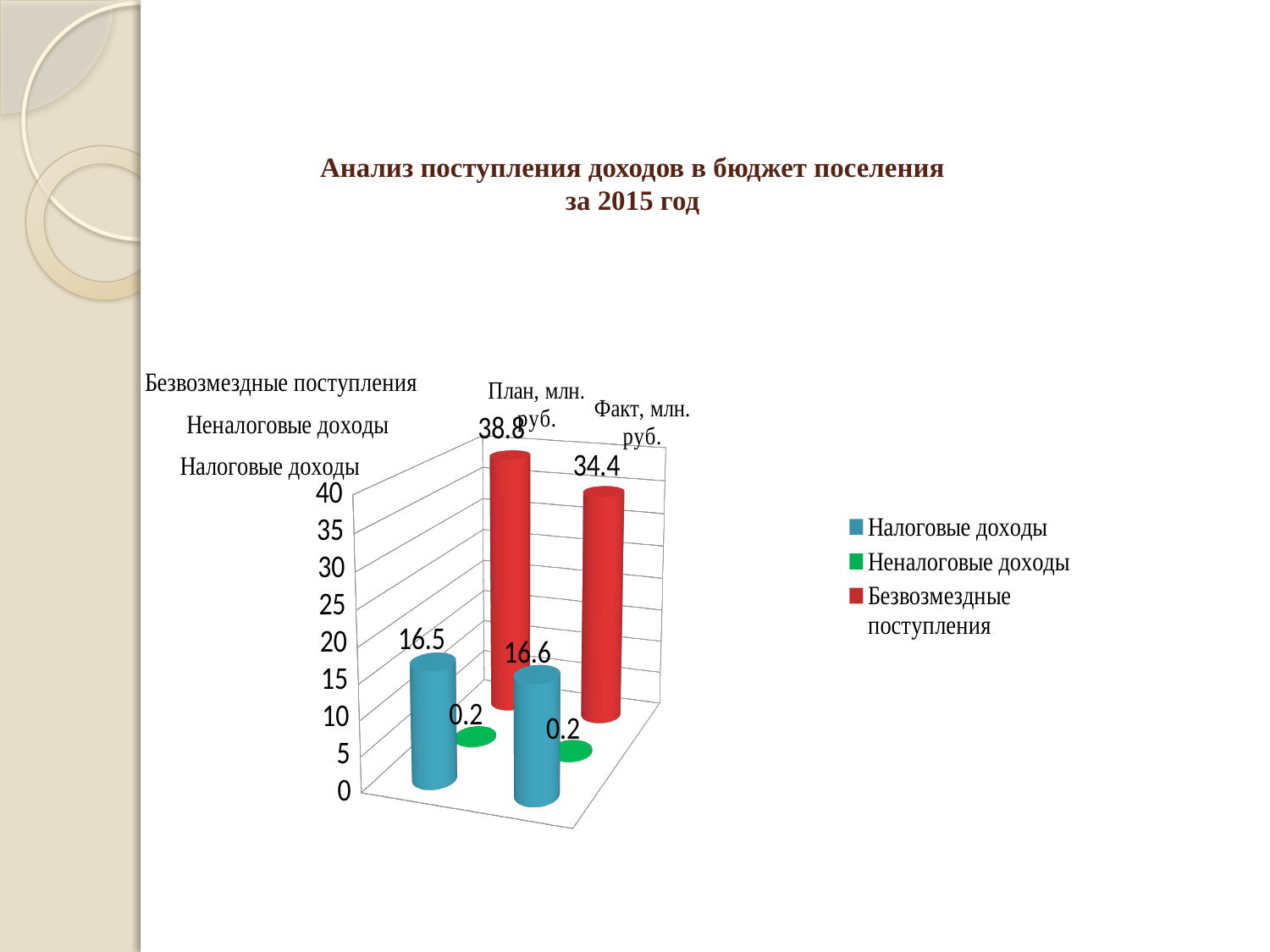
What kind of chart is shown on the slide? bar chart What is the value of Неналоговые доходы for Факт, млн. руб.? 0.2 What is the value of Налоговые доходы for Факт, млн. руб.? 16.6 Which series has the lowest value for Факт, млн. руб.? Неналоговые доходы What is the title of the slide's chart? Анализ поступления доходов в бюджет поселения за 2015 год What is the difference between the План and Факт values for Безвозмездные поступления? 4.4 How many series does the legend list? 3 Which series has the highest value for План, млн. руб.? Безвозмездные поступления What is the value of Безвозмездные поступления for План, млн. руб.? 38.8 Is the value of Безвозмездные поступления for План larger or smaller than for Факт? larger What is the value of Налоговые доходы for План, млн. руб.? 16.5 What is the value of Безвозмездные поступления for Факт, млн. руб.? 34.4